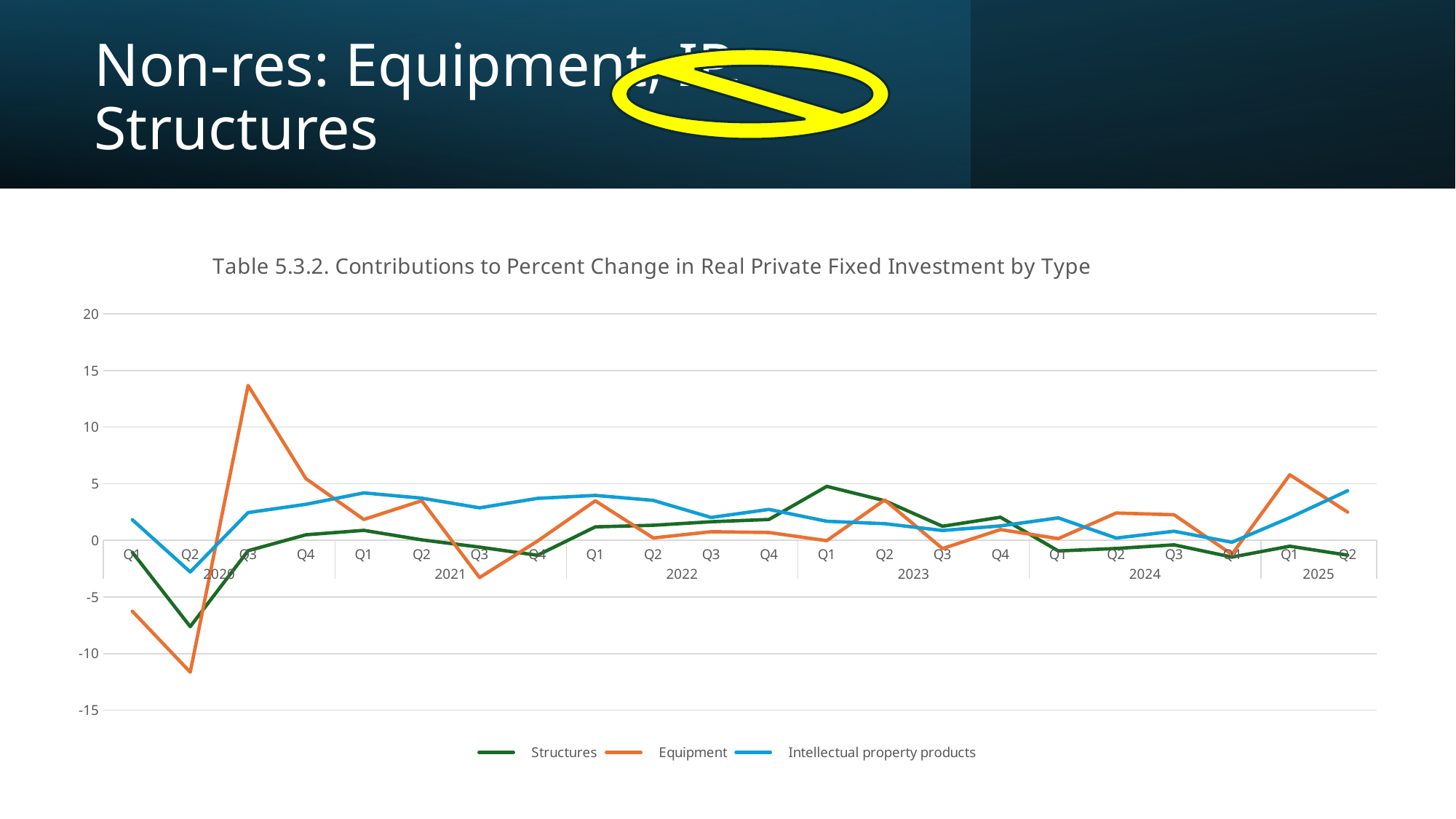
Which series reaches the highest value anywhere on the chart? Equipment Is the value for Structures in Q2 2020 greater or less than -5? less Which series reaches the lowest value anywhere on the chart? Equipment What is the title of the chart? Table 5.3.2. Contributions to Percent Change in Real Private Fixed Investment by Type Is the value for Equipment in Q3 2020 greater or less than 10? greater What kind of chart is shown on the slide? Line chart How many quarterly data points are plotted along the x axis? 22 In Q2 2025, which is larger: Intellectual property products or Equipment? Intellectual property products Which series is drawn in orange? Equipment In Q1 2023, which is larger: Structures or Equipment? Structures Is the value for Equipment in Q2 2020 greater or less than -10? less How many series does the legend list? 3